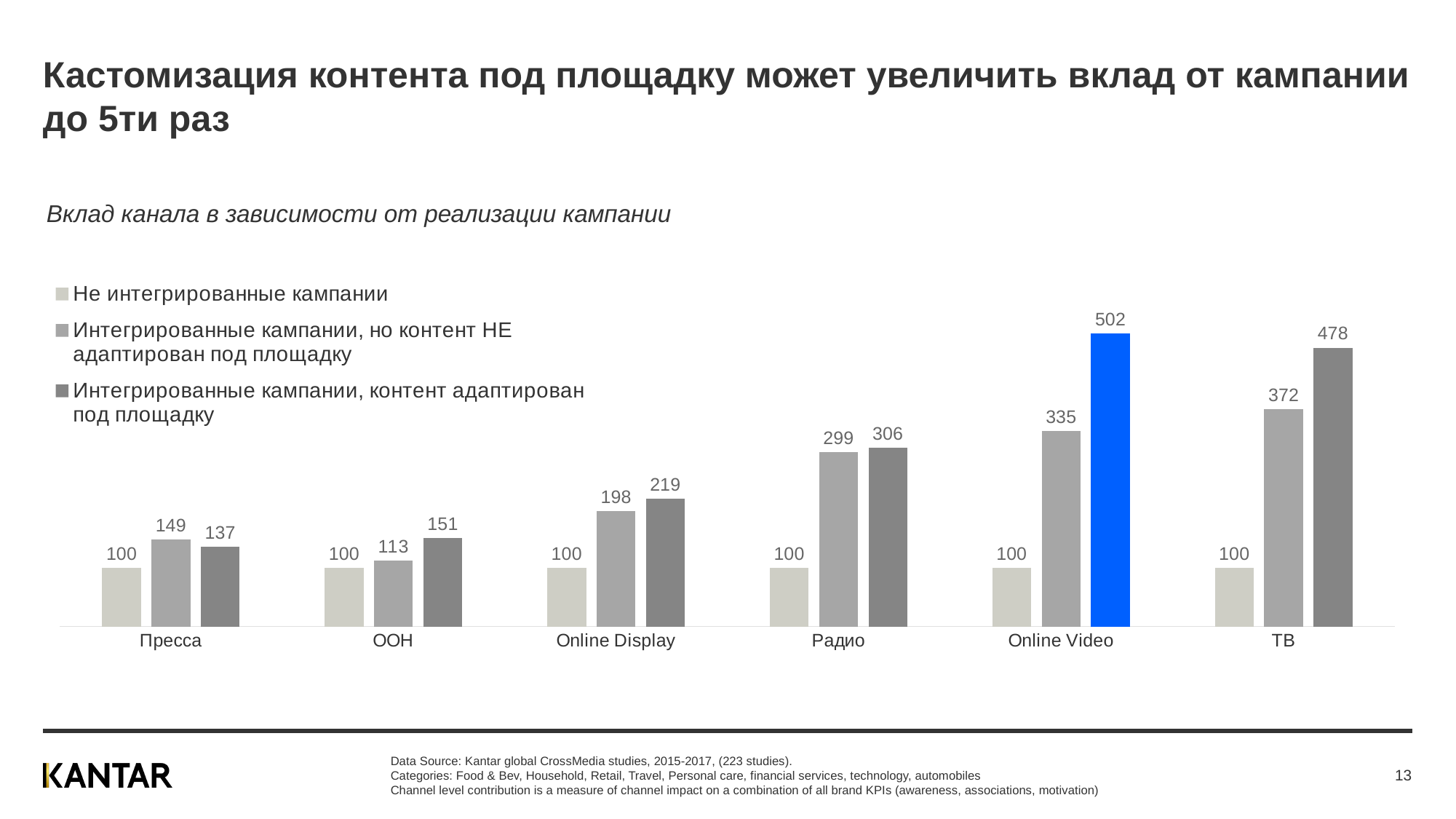
How many series does the legend list? 3 Which category has the lowest value in the series "Интегрированные кампании, но контент НЕ адаптирован под площадку"? OOH What type of chart is shown on the slide? Bar chart Which bar in the chart is highlighted in blue? Online Video, Интегрированные кампании, контент адаптирован под площадку How many categories are shown on the x axis? 6 What is the difference between the two integrated-campaign values for Радио (306 and 299)? 7 What is the value for Online Video in the series "Интегрированные кампании, контент адаптирован под площадку"? 502 For Пресса, which is larger: the value for "Интегрированные кампании, но контент НЕ адаптирован под площадку" or for "Интегрированные кампании, контент адаптирован под площадку"? Интегрированные кампании, но контент НЕ адаптирован под площадку Which category has the highest value in the series "Интегрированные кампании, контент адаптирован под площадку"? Online Video What is the value for Пресса in the series "Не интегрированные кампании"? 100 What is the difference between the values for ТВ and Online Video in the series "Интегрированные кампании, контент адаптирован под площадку"? 24 What is the value for ТВ in the series "Интегрированные кампании, но контент НЕ адаптирован под площадку"? 372